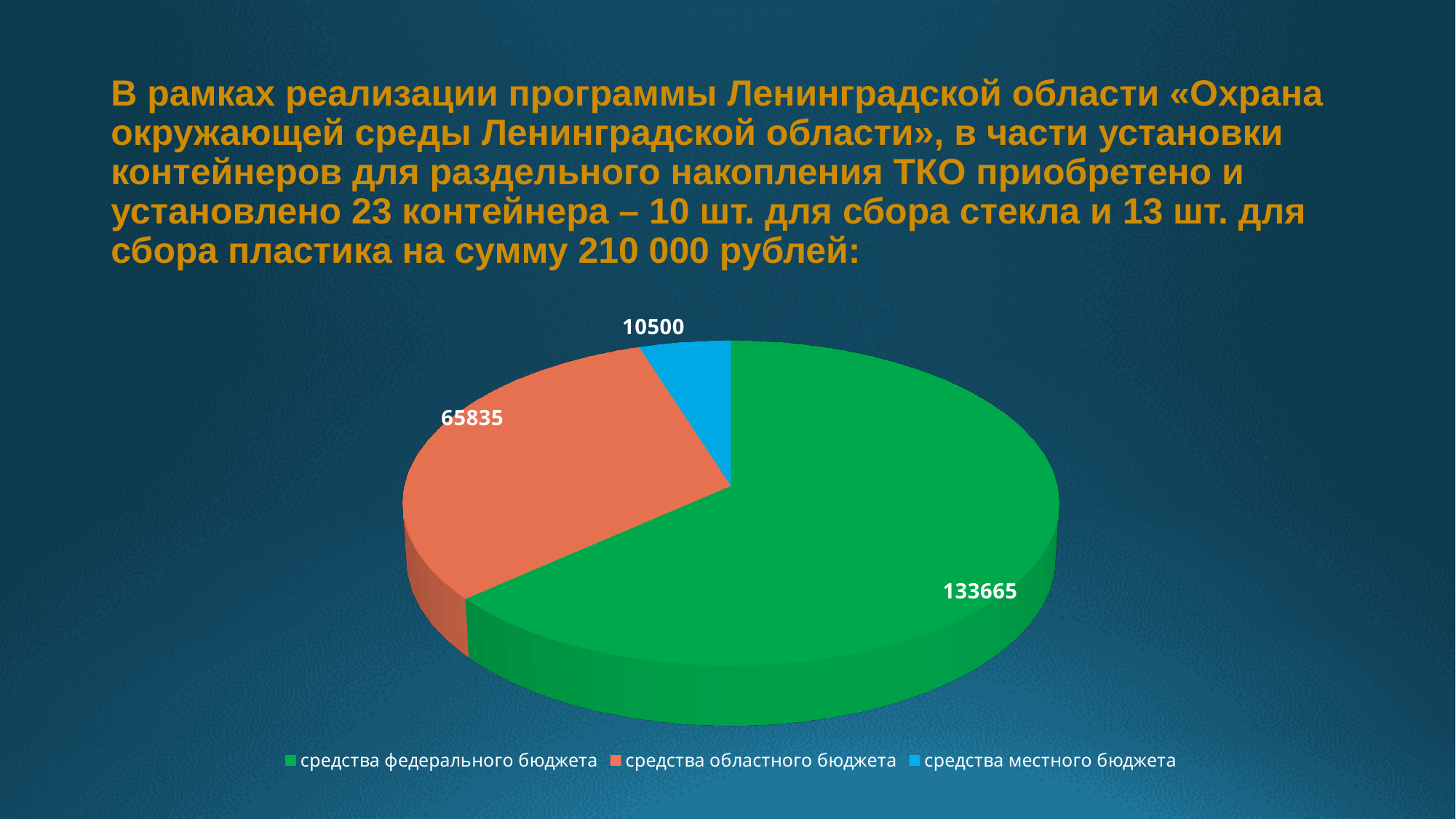
What colour is the slice for средства областного бюджета? orange How many slices does the pie chart have? 3 What is the value for средства областного бюджета? 65835 What is the difference between средства федерального бюджета and средства областного бюджета? 67830 What is the value for средства местного бюджета? 10500 What is the difference between средства областного бюджета and средства местного бюджета? 55335 What is the value for средства федерального бюджета? 133665 Which is larger: средства областного бюджета or средства местного бюджета? средства областного бюджета What share of the pie does средства местного бюджета represent? 5% What kind of chart is shown on the slide? pie chart Which budget source has the smallest slice of the pie? средства местного бюджета Which budget source has the largest slice of the pie? средства федерального бюджета